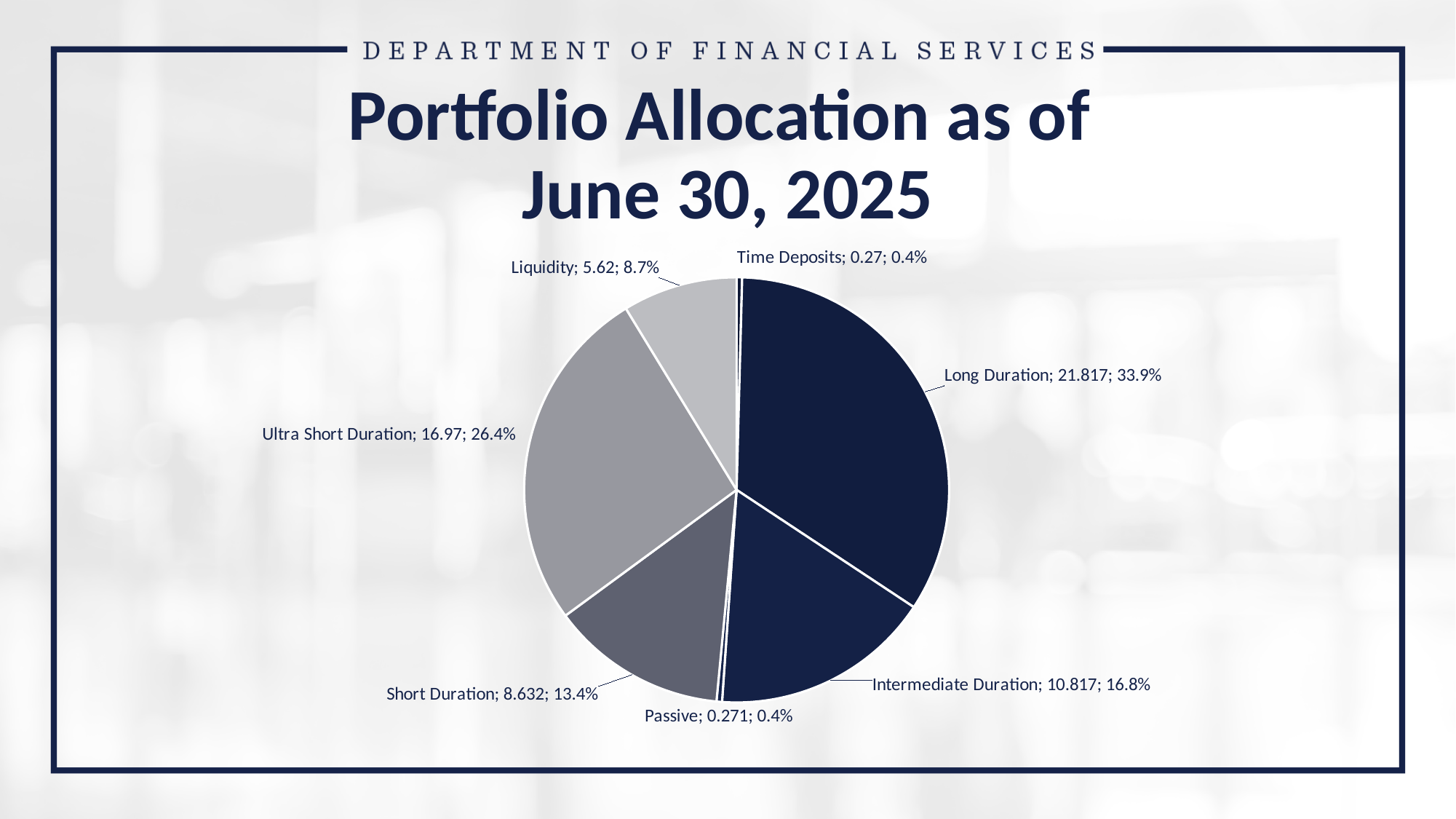
What is the title of the chart? Portfolio Allocation as of June 30, 2025 What is the value for Liquidity? 5.62 Which is larger, Intermediate Duration or Short Duration? Intermediate Duration How many categories are shown in the pie chart? 7 What is the value for Long Duration? 21.817 Which category has the largest slice of the pie? Long Duration What is the value for Ultra Short Duration? 16.97 What is the difference between the values for Long Duration and Ultra Short Duration? 4.847 What kind of chart is shown on the slide? pie chart What share of the pie does Ultra Short Duration represent? 26.4% What share of the pie does Short Duration represent? 13.4% What is the value for Intermediate Duration? 10.817